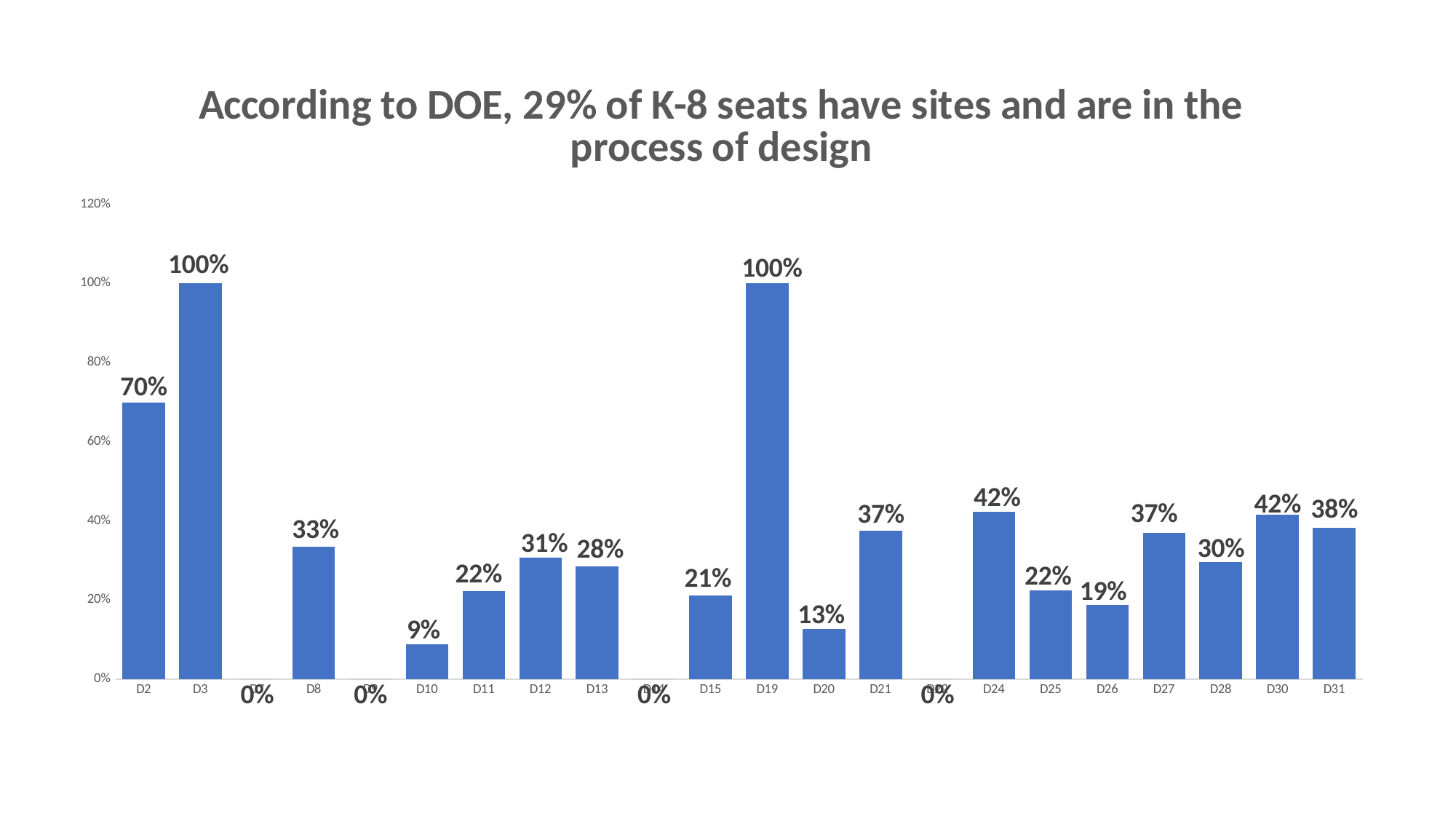
What is the difference between the values for D24 and D26? 23 percentage points Which has a larger value, D27 or D28? D27 What is the value for D10? 9% Is the value for D21 greater or less than 20%? greater How many bars reach 100%? 2 What kind of chart is shown on the slide? Bar chart What is the value for D8? 33% What is the value for D2? 70% What is the value for D20? 13% What is the difference between the values for D3 and D2? 30 percentage points Which has a larger value, D12 or D13? D12 What is the value for D31? 38%